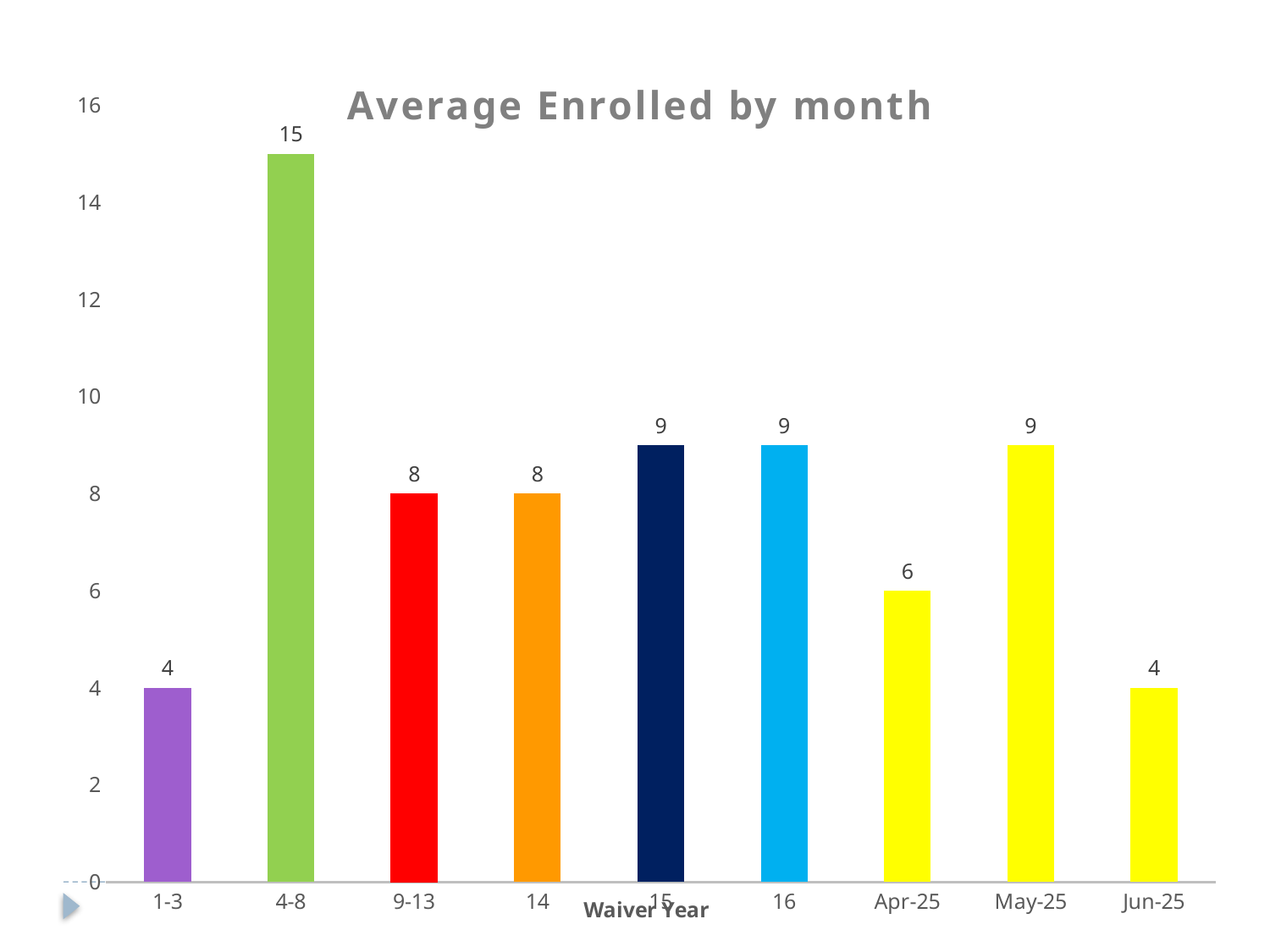
Which is larger, the value for 15 or the value for Apr-25? 15 How many categories are shown on the x axis? 9 What is the difference between the values for 4-8 and 1-3? 11 What is the title of the chart? Average Enrolled by month Which category has the highest average enrolled? 4-8 What is the value shown for Apr-25? 6 What is the value shown for waiver year 9-13? 8 What is the difference between the values for May-25 and Jun-25? 5 What kind of chart is this? bar chart What is the average enrolled value for waiver year 4-8? 15 Is the value for 4-8 greater or less than 10? greater What is the x-axis title of the chart? Waiver Year